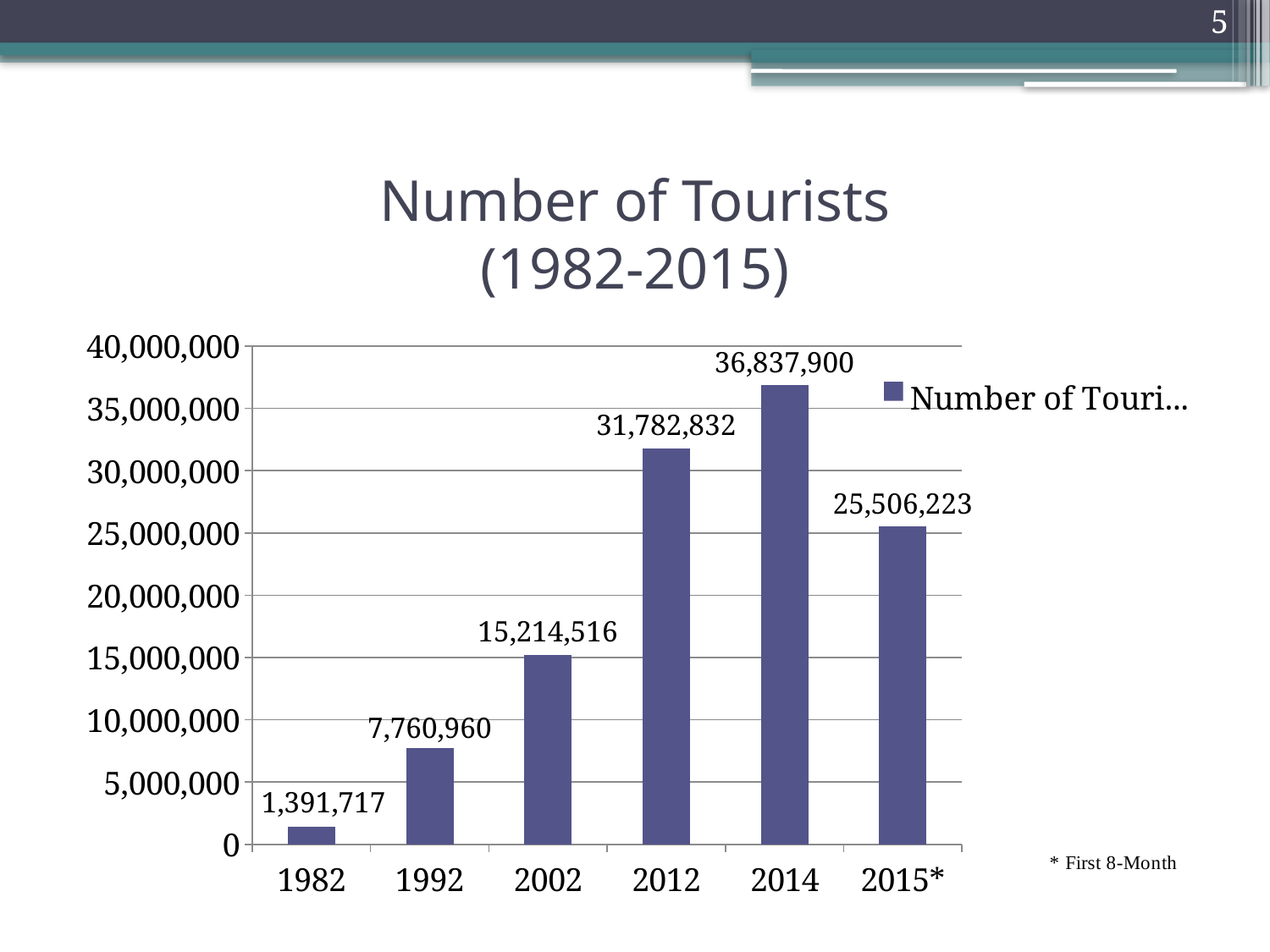
Is the value for 2002 greater or less than 20,000,000? less Which year has the highest number of tourists? 2014 What is the difference between the values for 2002 and 1992? 7,453,556 Do the values rise or fall from 1982 to 2014? rise Which year has the lowest number of tourists? 1982 Which is larger, the value for 2012 or the value for 2015*? 2012 What is the difference between the values for 2014 and 2012? 5,055,068 How many years are shown on the x axis? 6 What kind of chart is shown on the slide? bar chart What value is shown for 2015*? 25,506,223 What is the number of tourists shown for 2012? 31,782,832 What is the number of tourists shown for 1982? 1,391,717